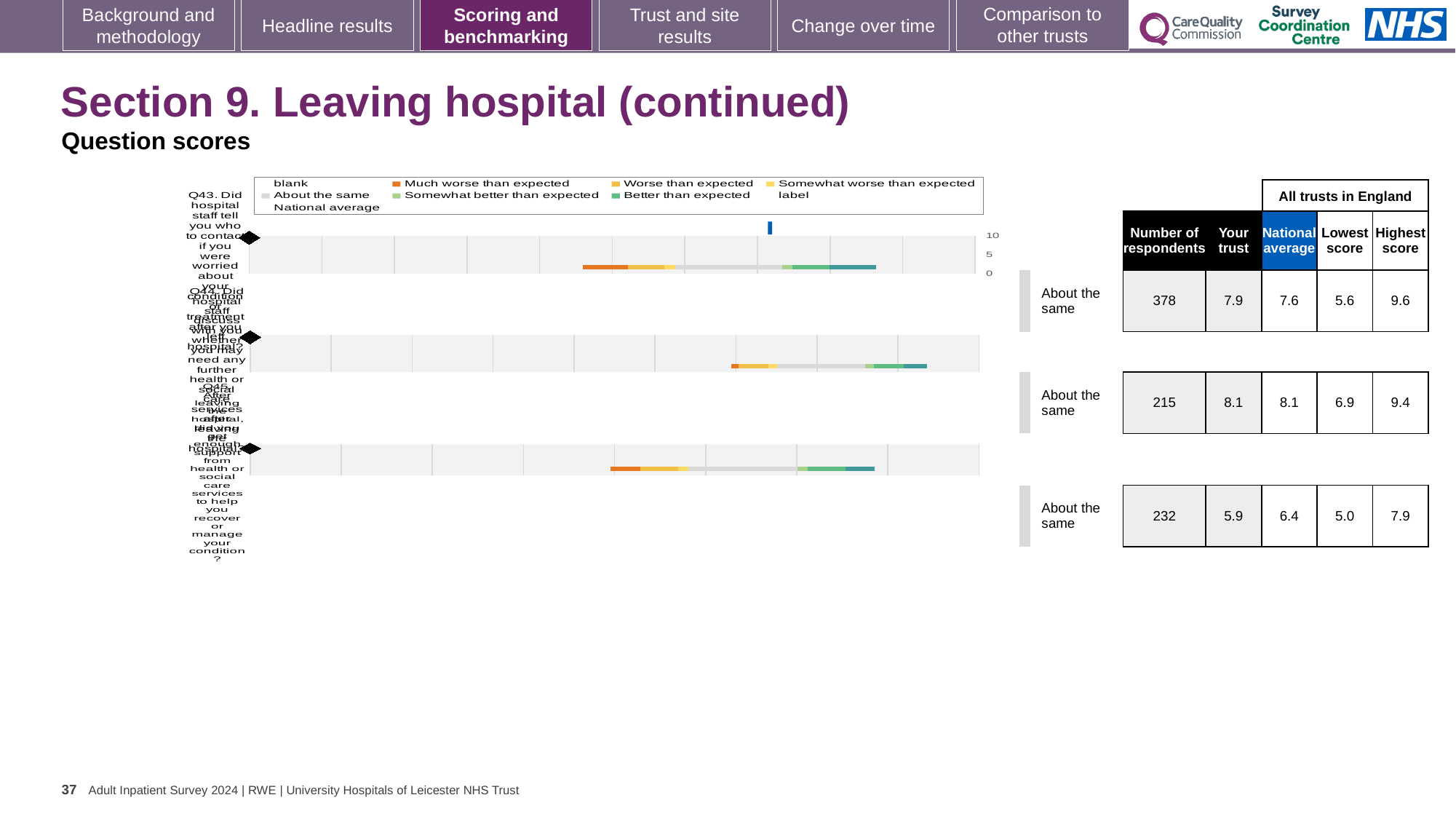
How many respondents answered Q45 (enough support after leaving hospital)? 232 Which question has the highest 'Your trust' score? Q44 What is the national average score for Q44 (discussing further health or social care services)? 8.1 For Q45, which is larger: the 'Your trust' score or the national average? National average For Q45, what is the difference between the highest score and the lowest score among all trusts in England? 2.9 What kind of chart is shown on the slide? bar chart What is the highest score among all trusts in England for Q44? 9.4 How many questions (categories) are plotted in the chart? 3 What is the 'Your trust' score for Q43 (who to contact if worried after leaving hospital)? 7.9 What benchmark category is shown for Q43? About the same For Q43, how much higher is the 'Your trust' score than the national average? 0.3 Which question has the lowest 'Your trust' score? Q45